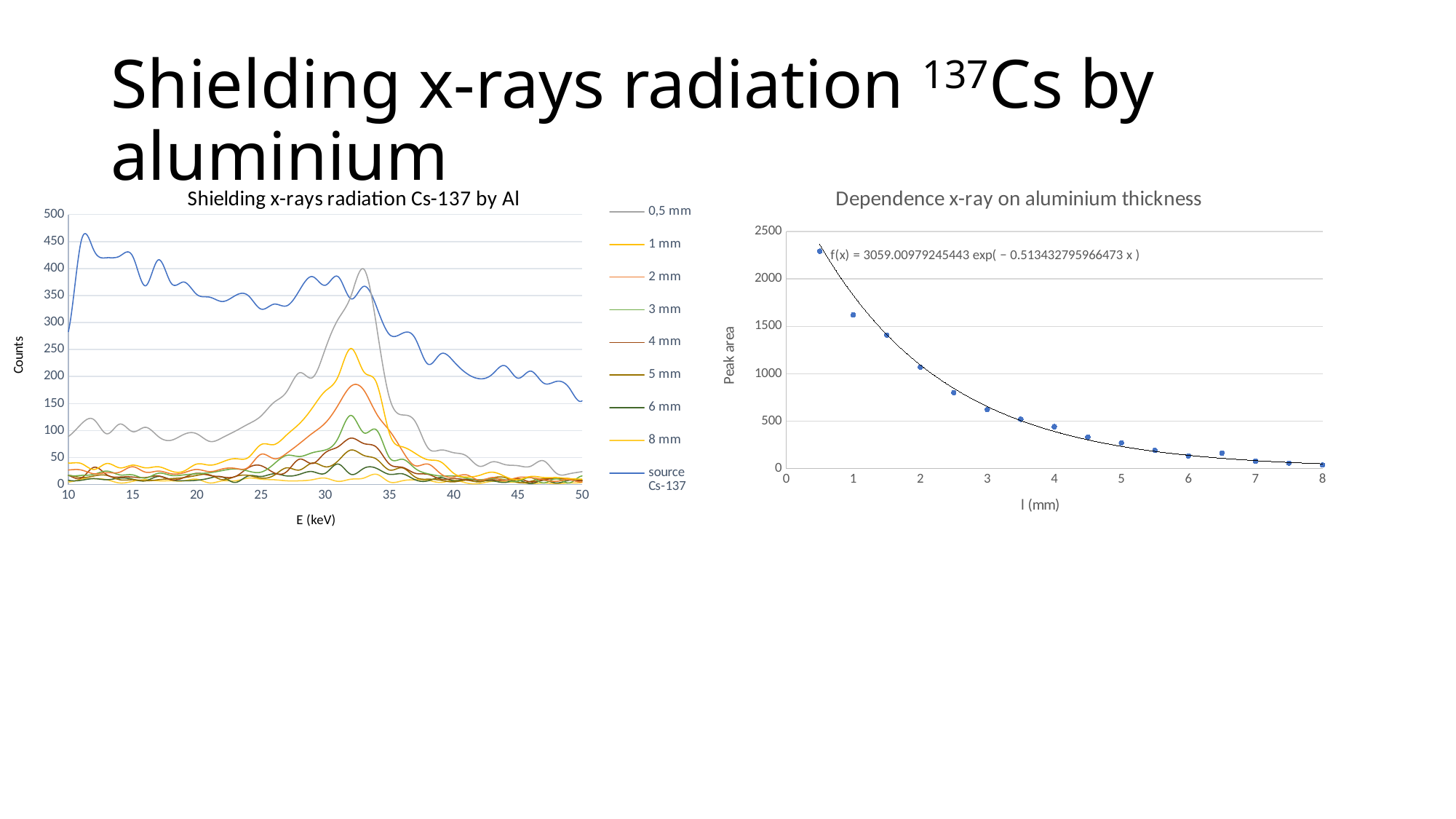
In the left chart "Shielding x-rays radiation Cs-137 by Al", what is the label of the x axis? E (keV) What kind of chart is the left chart titled "Shielding x-rays radiation Cs-137 by Al"? line chart In the right chart "Dependence x-ray on aluminium thickness", does the peak area rise or fall as l (mm) increases? fall In the right chart "Dependence x-ray on aluminium thickness", which has the larger peak area: l = 1 mm or l = 2 mm? l = 1 mm How many series does the legend of the left chart "Shielding x-rays radiation Cs-137 by Al" list? 9 In the right chart "Dependence x-ray on aluminium thickness", how many data points are plotted? 16 In the left chart "Shielding x-rays radiation Cs-137 by Al", at around 32 keV, which series has the higher counts: 1 mm or 2 mm? 1 mm In the left chart "Shielding x-rays radiation Cs-137 by Al", which series reaches the highest counts overall? source Cs-137 In the left chart "Shielding x-rays radiation Cs-137 by Al", is the peak value of the 1 mm series greater or less than 200? greater In the right chart "Dependence x-ray on aluminium thickness", is the peak area at l = 0.5 mm greater or less than 2000? greater What is the title of the right chart? Dependence x-ray on aluminium thickness In the left chart "Shielding x-rays radiation Cs-137 by Al", is the peak value of the 0,5 mm series greater or less than 350? greater